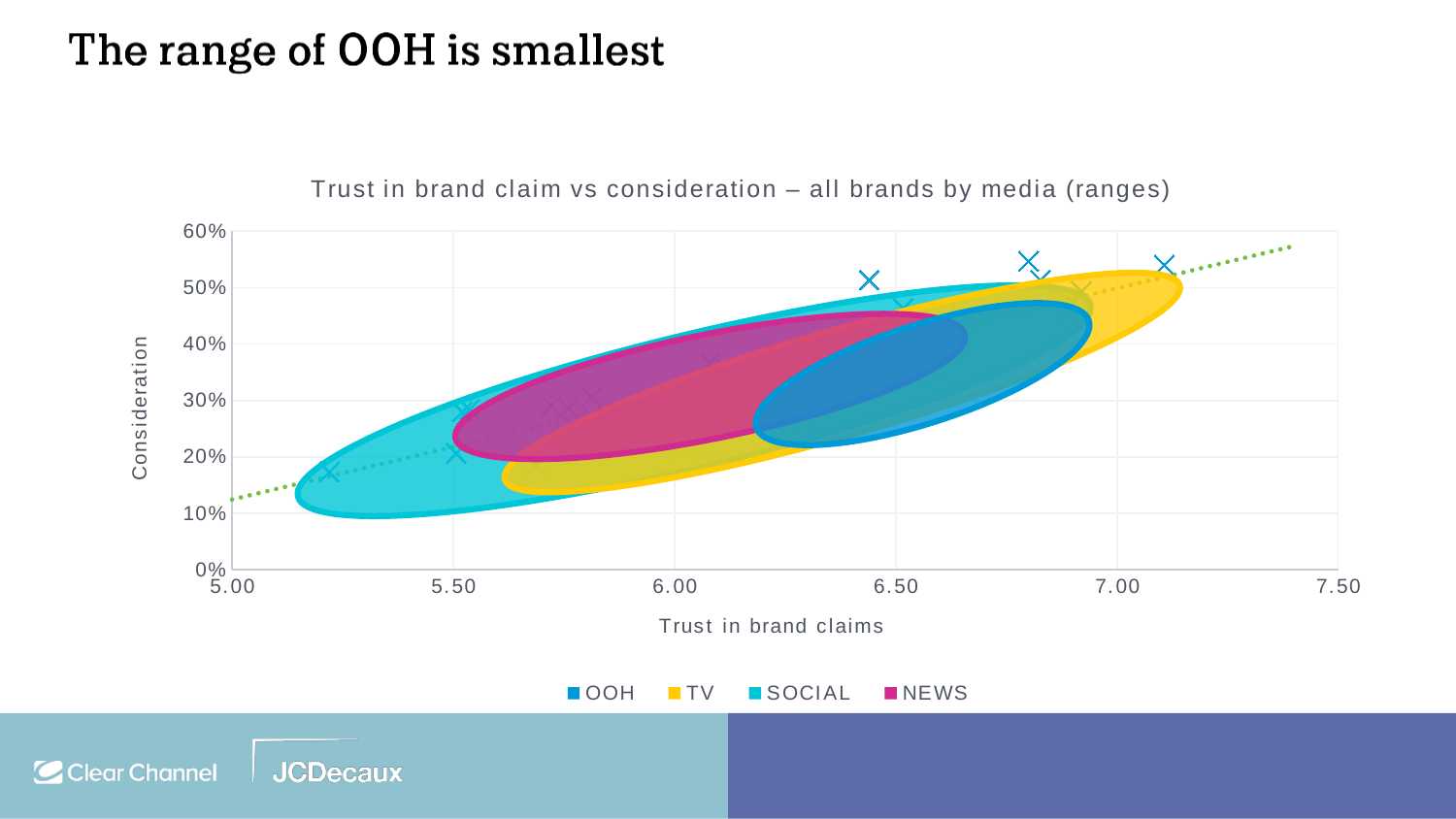
Which media's range extends to the highest trust in brand claims value? TV How many series does the legend list? 4 Does consideration rise or fall as trust in brand claims increases along the x axis? rise Which media are listed in the chart legend? OOH, TV, SOCIAL, NEWS What is the title of the chart? Trust in brand claim vs consideration – all brands by media (ranges) According to the slide, which media has the smallest range? OOH Which media's range extends to the lowest trust in brand claims value? SOCIAL What kind of chart is shown on the slide? scatter chart What is the highest value shown on the y axis? 60%